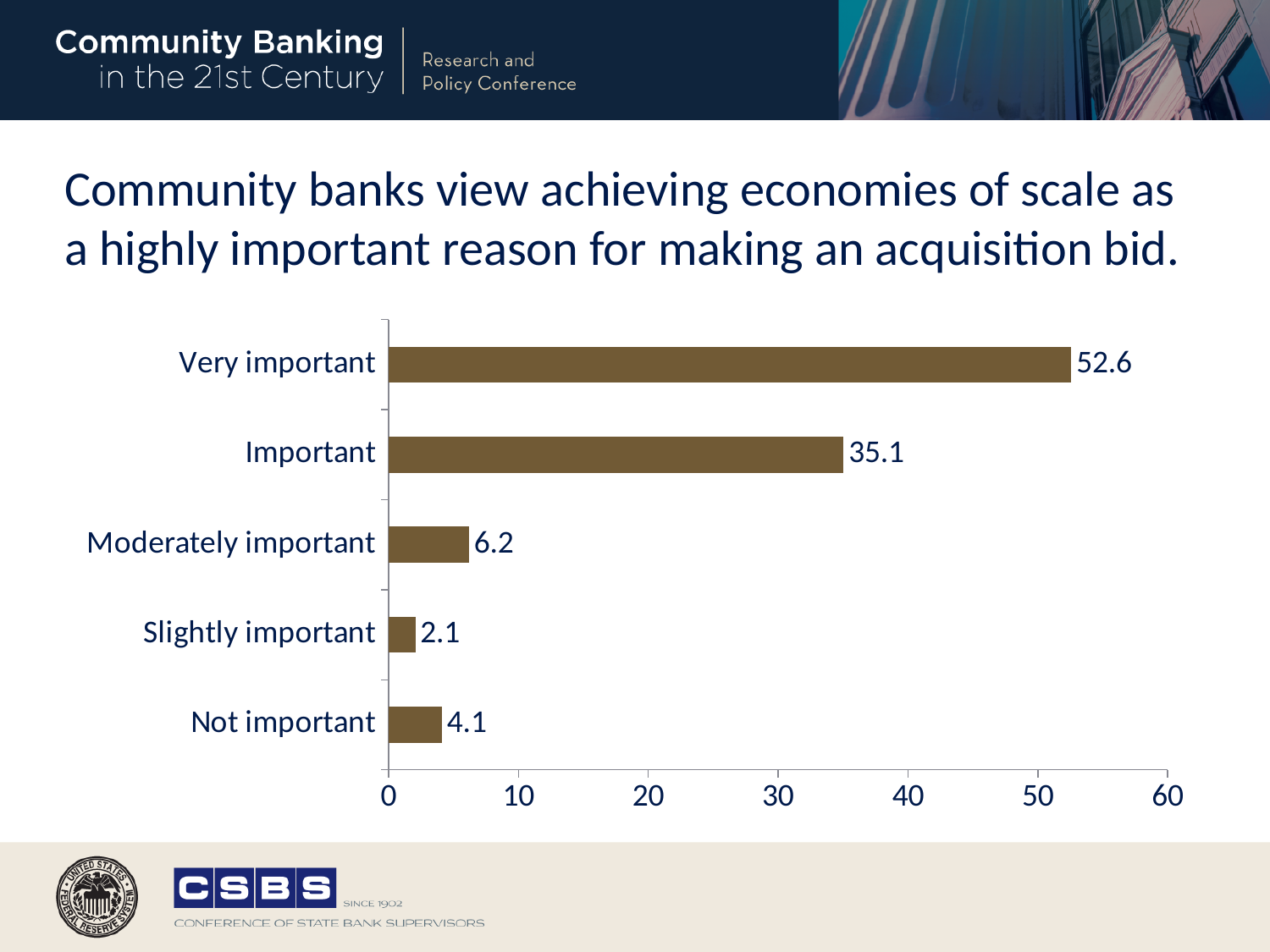
What is the value for Important? 35.1 What is the value for Very important? 52.6 What is the value for Slightly important? 2.1 What is the difference between the values for Very important and Important? 17.5 Which is larger, the value for Not important or the value for Slightly important? Not important What is the value for Not important? 4.1 Is the value for Important greater or less than 30? greater Which category has the highest value? Very important What is the value for Moderately important? 6.2 How many categories are shown in the chart? 5 What kind of chart is shown on the slide? bar chart Which category has the lowest value? Slightly important